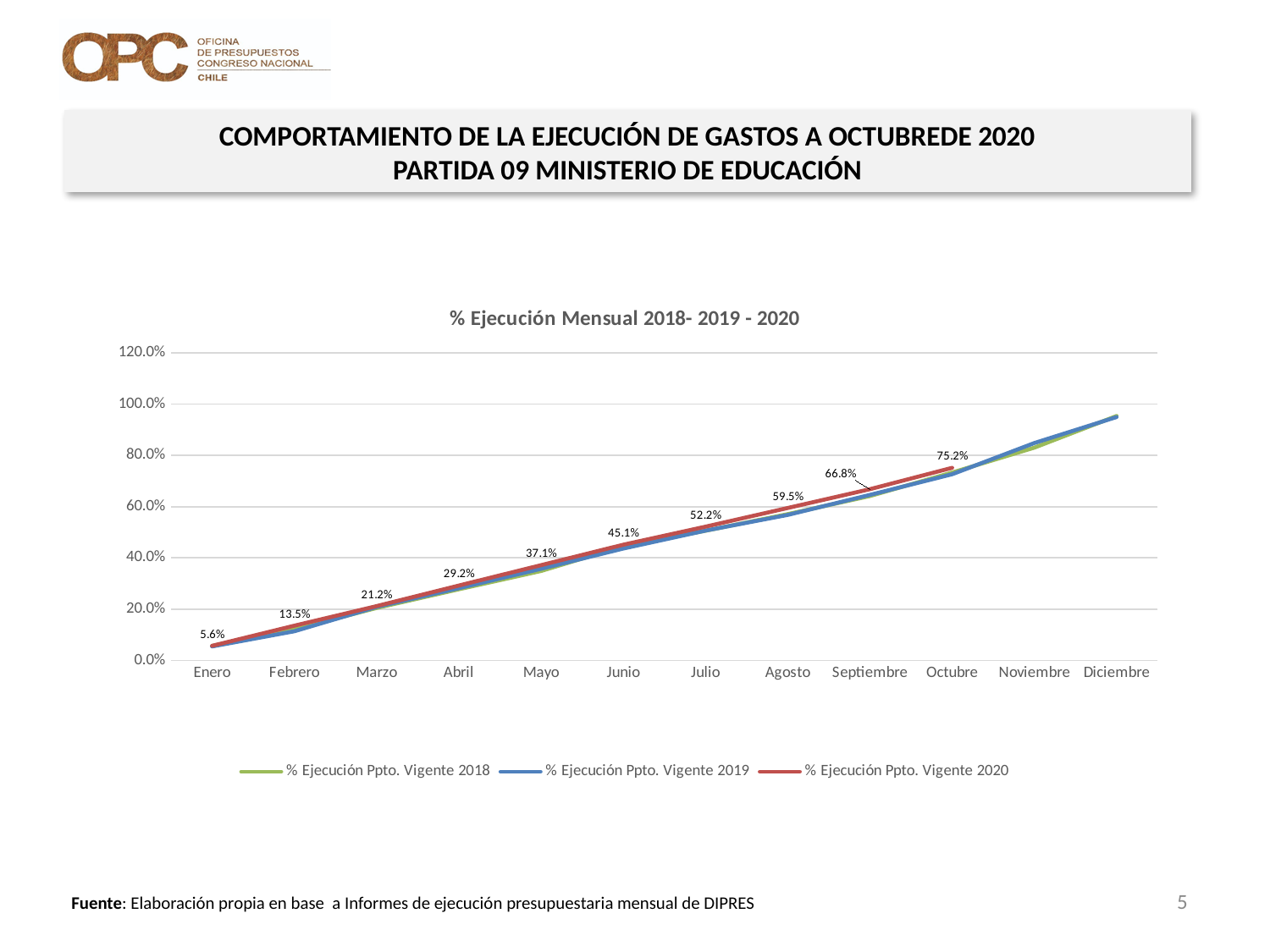
What is the labelled value for % Ejecución Ppto. Vigente 2020 in Octubre? 75.2% What is the difference between the 2020 values for Octubre (75.2%) and Septiembre (66.8%)? 8.4% What is the labelled value for % Ejecución Ppto. Vigente 2020 in Agosto? 59.5% Is the value for % Ejecución Ppto. Vigente 2019 in Diciembre greater or less than 80.0%? greater What type of chart is shown on the slide? line chart How many series does the legend list? 3 What is the labelled value for % Ejecución Ppto. Vigente 2020 in Mayo? 37.1% What is the labelled value for % Ejecución Ppto. Vigente 2020 in Enero? 5.6% What is the title of the chart? % Ejecución Mensual 2018- 2019 - 2020 How many months are shown on the x axis? 12 Do the values of the % Ejecución Ppto. Vigente 2020 line rise or fall from Enero to Octubre? rise What is the difference between the 2020 values for Junio (45.1%) and Enero (5.6%)? 39.5%